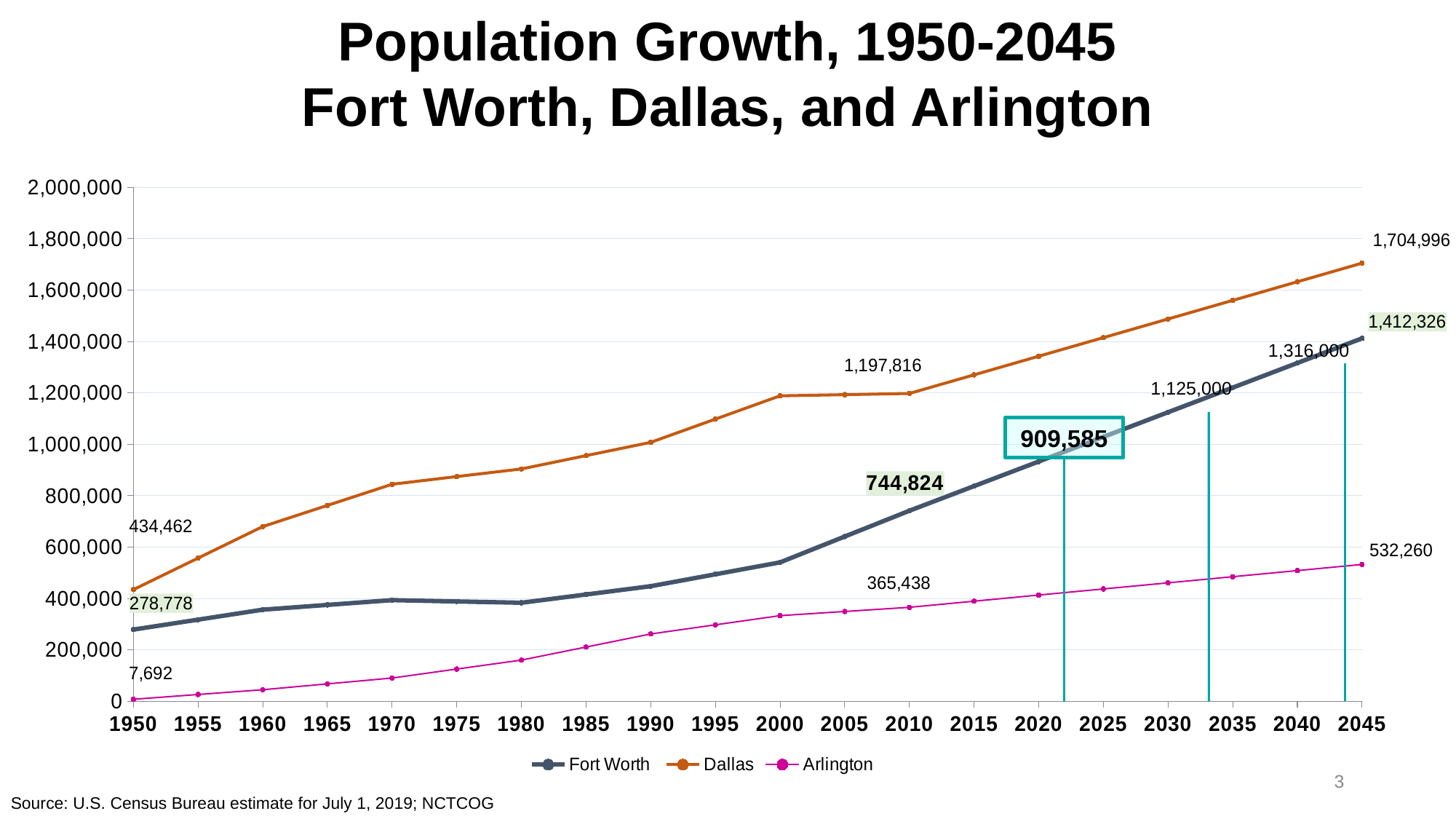
Does the Arlington population rise or fall from 1950 to 2045? rises What is the population value shown for Fort Worth in 2045? 1,412,326 What is the difference between the Dallas and Fort Worth populations in 2045? 292,670 Which city has the lowest population in 1950? Arlington Is the value for Fort Worth in 2000 greater or less than 600,000? less What is the population value shown for Dallas in 1950? 434,462 What is the population value shown for Dallas in 2010? 1,197,816 What kind of chart is shown on the slide? line chart What is the population value shown for Arlington in 1950? 7,692 Which city has the highest population in 2045? Dallas How many series does the legend list? 3 Which is larger in 2010, the population of Fort Worth or of Arlington? Fort Worth